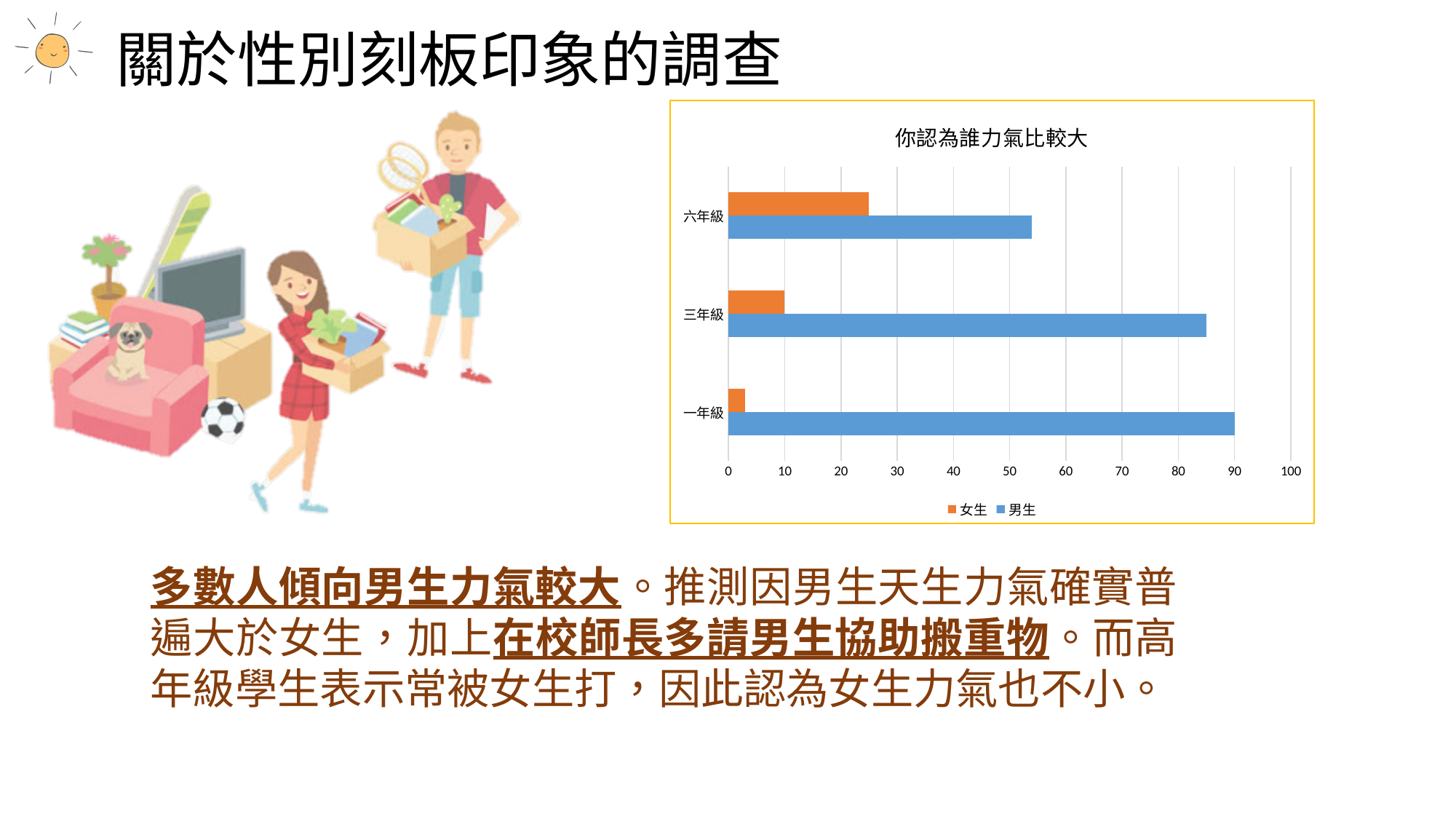
Which grade has the highest value for 女生? 六年級 What is the title of the chart? 你認為誰力氣比較大 Which colour represents 女生 in the chart? orange For 六年級, which is larger, the value for 男生 or the value for 女生? 男生 Which grade has the lowest value for 女生? 一年級 How many series does the chart legend list? 2 Is the value for 女生 in 六年級 greater or less than 30? less What kind of chart is shown on the slide? bar chart How many grade categories are shown on the chart? 3 Is the value for 男生 in 三年級 greater or less than 80? greater Which grade has the lowest value for 男生? 六年級 Is the value for 男生 in 六年級 greater or less than 50? greater